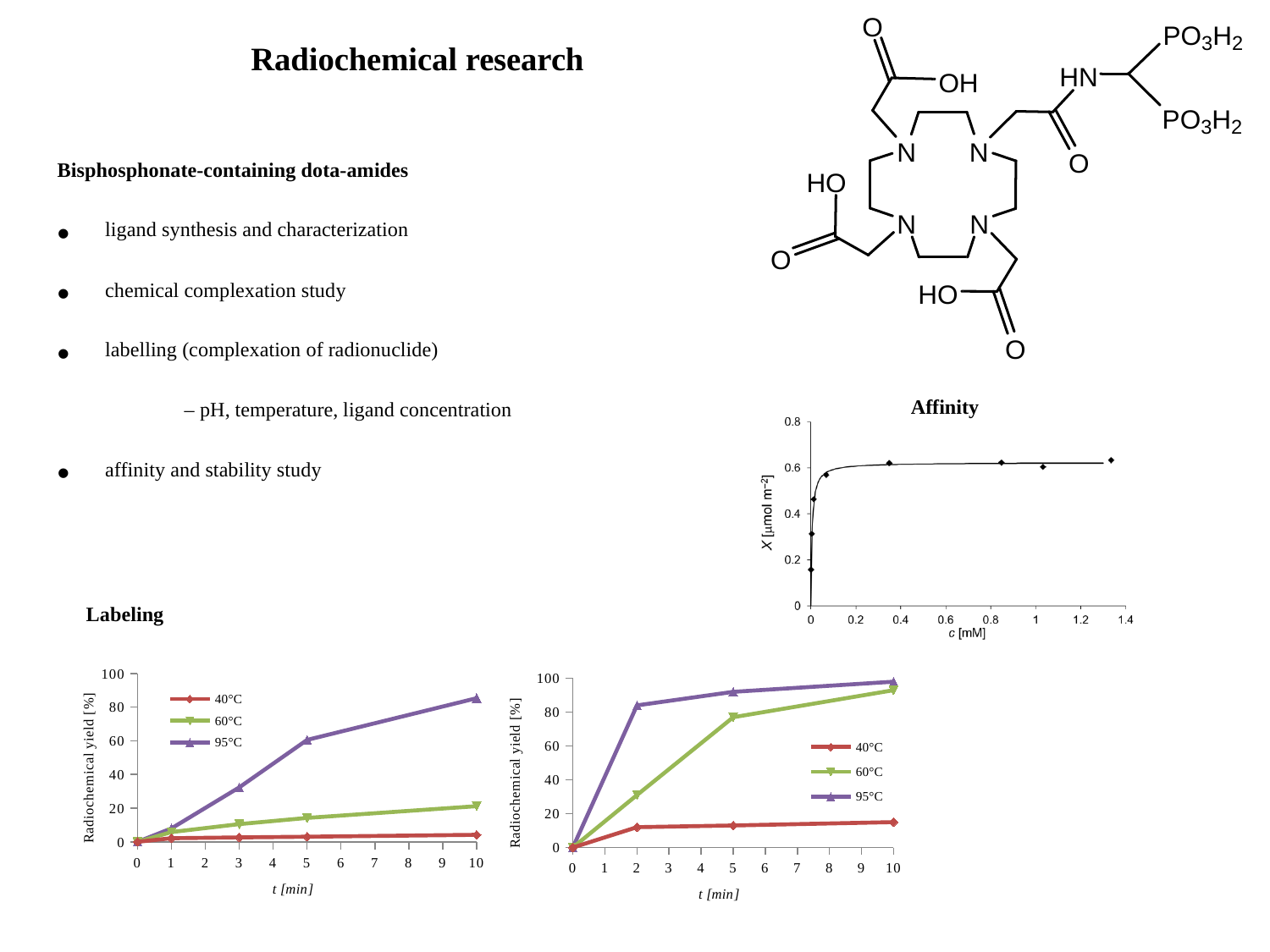
What is the x-axis label of the Affinity chart? c [mM] On the Affinity chart, is the value of X at c = 1.2 mM greater or less than 0.4? greater On the left Labeling chart, how many series does the legend list? 3 On the left Labeling chart, is the radiochemical yield for 60°C at t = 10 min greater or less than 40? less On the left Labeling chart, which temperature series has the highest radiochemical yield at t = 10 min? 95°C On the right Labeling chart, is the radiochemical yield for 40°C at t = 10 min greater or less than 20? less On the right Labeling chart, which temperature series has the lowest radiochemical yield at t = 10 min? 40°C What kind of chart is the Affinity chart? scatter chart On the right Labeling chart, which has the larger radiochemical yield at t = 5 min, 60°C or 40°C? 60°C On the left Labeling chart, does the radiochemical yield for 95°C rise or fall as t increases? rise